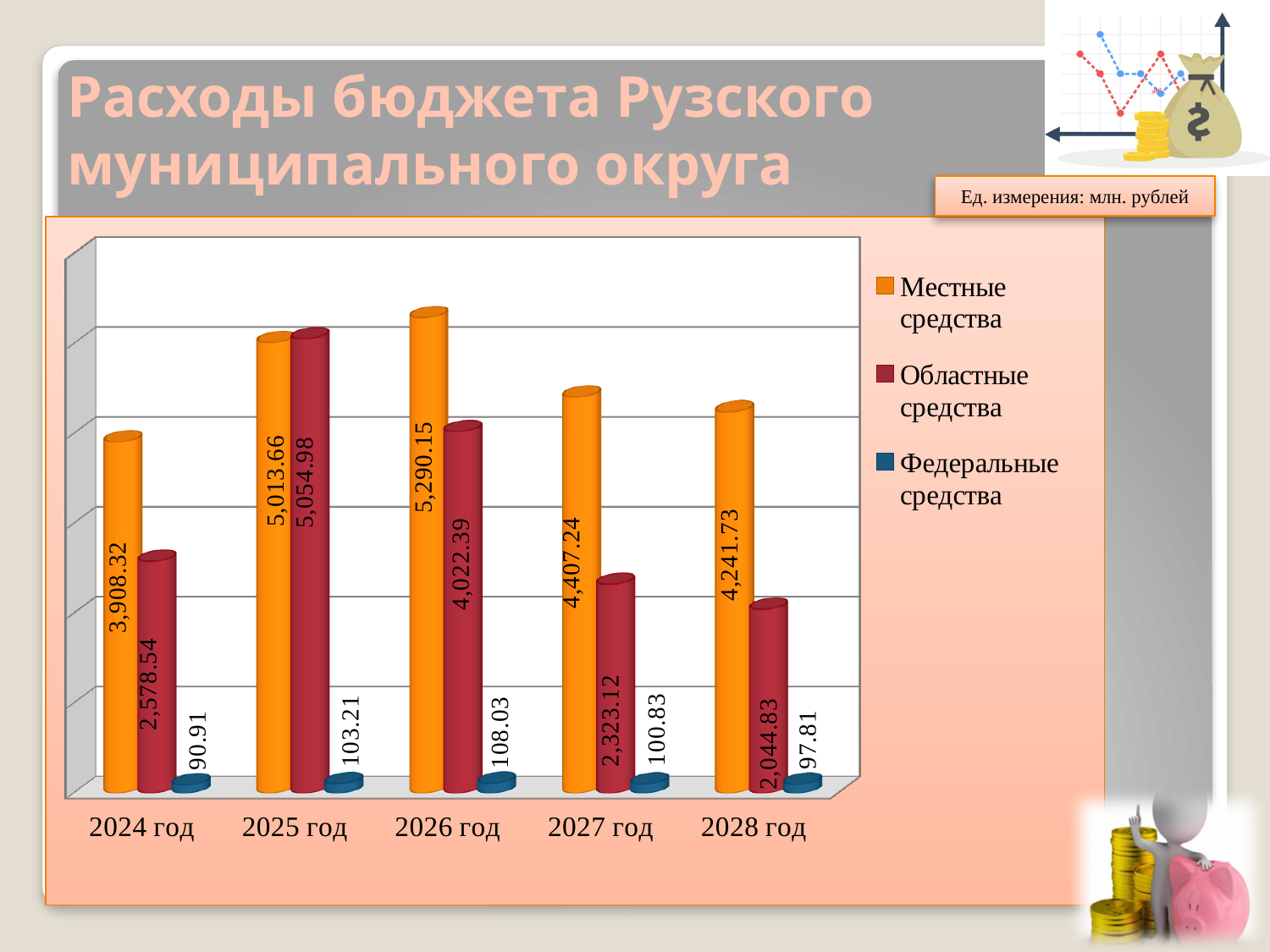
In which year are Областные средства the lowest? 2028 год How many years are shown on the x axis? 5 What is the value of Федеральные средства for 2027 год? 100.83 In which year are Федеральные средства the highest? 2026 год What is the difference between Областные средства and Местные средства in 2025 год? 41.32 In which year are Местные средства the highest? 2026 год What is the value of Местные средства for 2026 год? 5,290.15 Do Областные средства rise or fall from 2025 год to 2028 год? Fall What kind of chart is shown on the slide? Bar chart What is the value of Областные средства for 2024 год? 2,578.54 For 2025 год, which is larger: Местные средства or Областные средства? Областные средства How many series does the legend list? 3